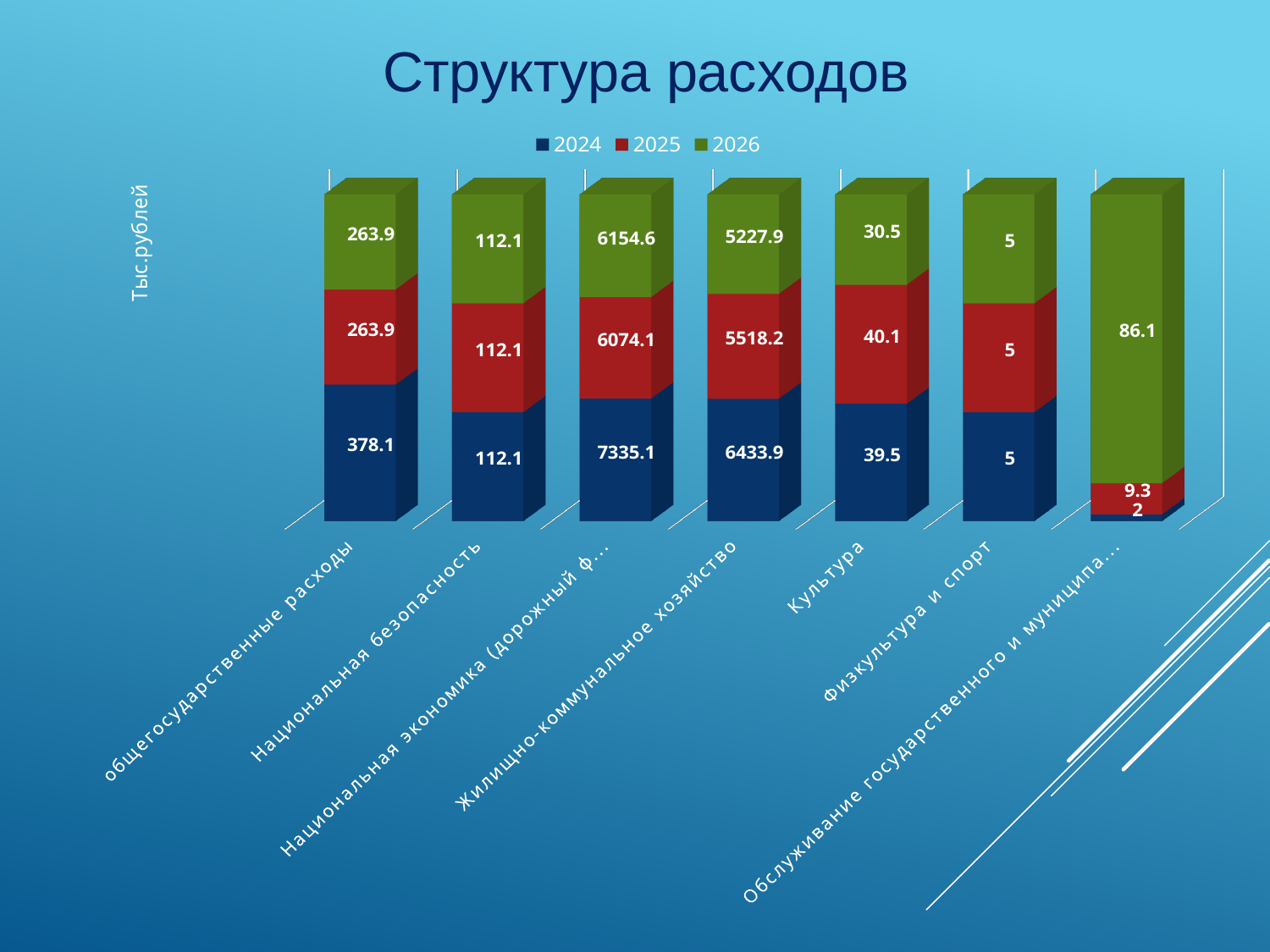
What is the 2025 value for Жилищно-коммунальное хозяйство? 5518.2 What is the 2026 value for Культура? 30.5 What is the total of the stacked bar for Физкультура и спорт? 15 Do the values for Жилищно-коммунальное хозяйство rise or fall from 2024 to 2026? fall What is the 2026 value for the rightmost bar (Обслуживание государственного и муниципа…)? 86.1 What is the 2024 value for Общегосударственные расходы? 378.1 Which year has the highest value for Общегосударственные расходы? 2024 How many categories are shown on the x axis? 7 What is the difference between the 2024 and 2025 values for Национальная экономика? 1261 Which is larger for Культура: the 2024 value or the 2025 value? 2025 What is the title of the chart? Структура расходов How many series does the legend list? 3